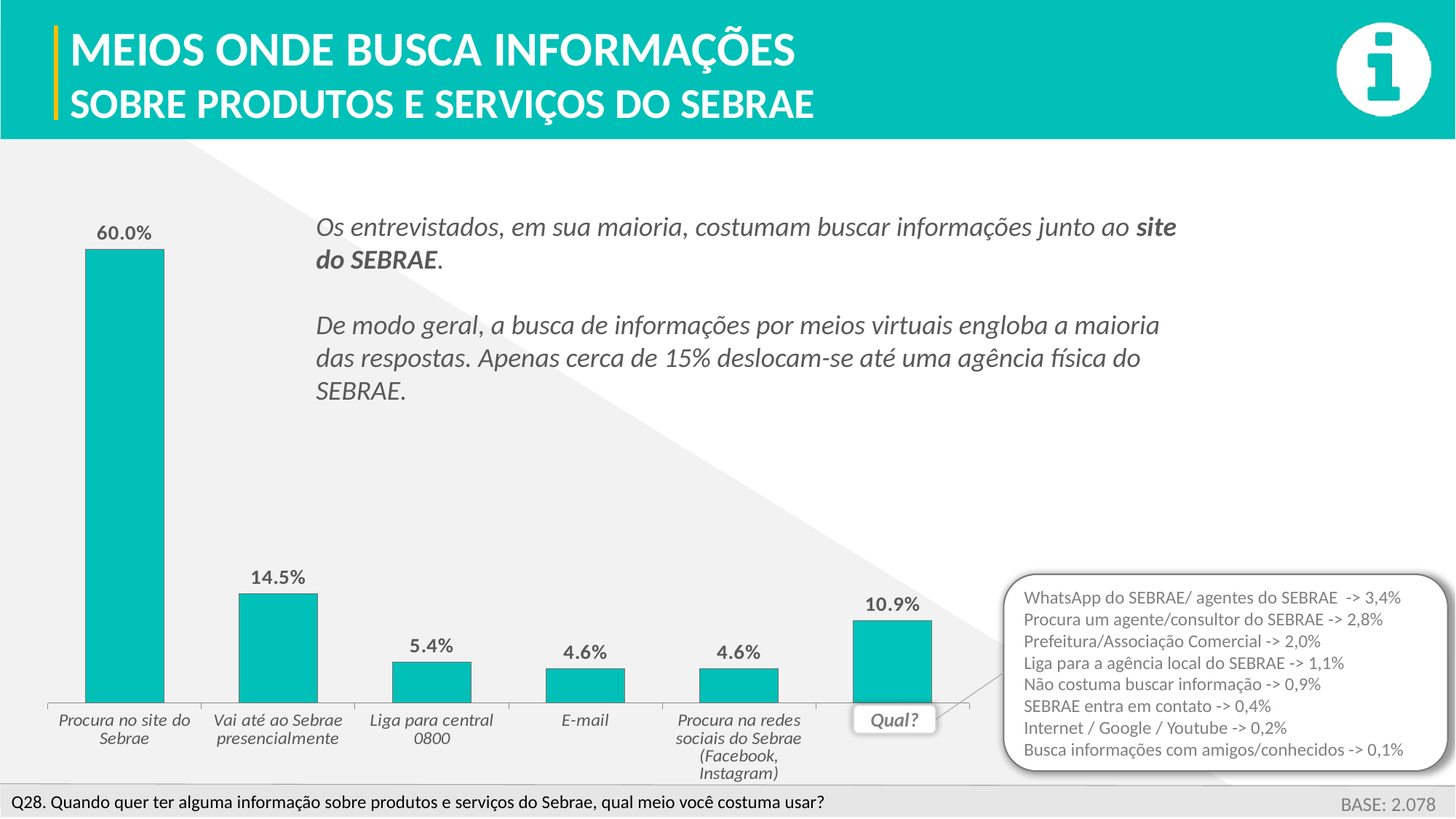
What is the value for "Vai até ao Sebrae presencialmente"? 14.5% Which category has the highest value? Procura no site do Sebrae What is the value for "E-mail"? 4.6% What is the difference between "Procura no site do Sebrae" and "Vai até ao Sebrae presencialmente"? 45.5% What is the value for "Procura no site do Sebrae"? 60.0% What is the difference between "Qual?" and "Liga para central 0800"? 5.5% What is the value for "Liga para central 0800"? 5.4% What is the value for the "Qual?" category? 10.9% How many categories are shown in the chart? 6 Which is larger, "Vai até ao Sebrae presencialmente" or "Qual?"? Vai até ao Sebrae presencialmente What kind of chart is shown on the slide? Bar chart What colour are the bars in the chart? Teal